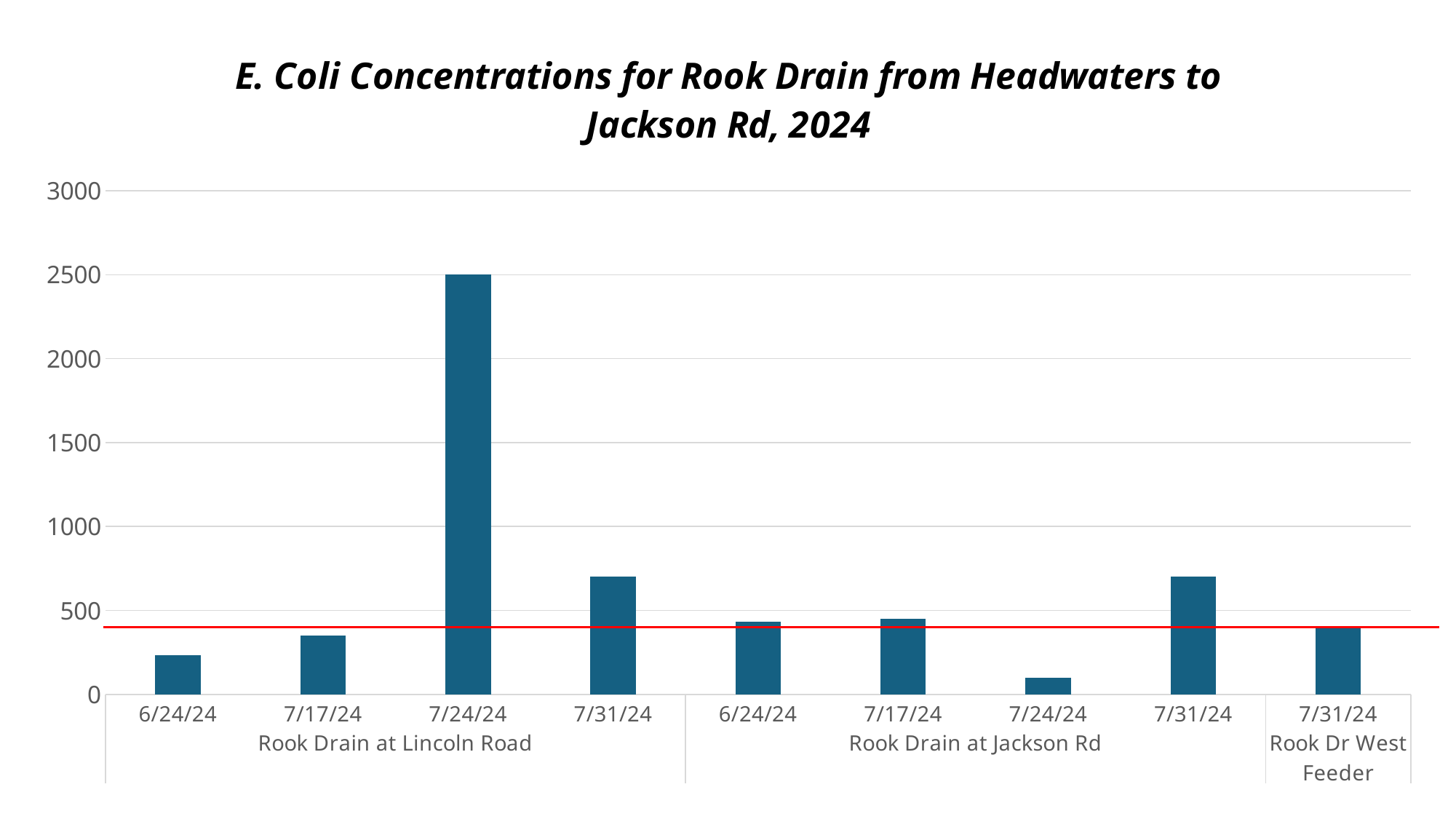
How many bars are plotted in the chart? 9 What is the title of the chart? E. Coli Concentrations for Rook Drain from Headwaters to Jackson Rd, 2024 What is the E. coli concentration for 7/24/24 at Rook Drain at Lincoln Road? 2500 What colour is the horizontal reference line drawn across the chart? Red Is the value for 6/24/24 at Rook Drain at Lincoln Road greater or less than 500? less How many sampling sites are labelled along the x axis? 3 Is the value for 7/31/24 at Rook Drain at Lincoln Road greater or less than 500? greater Which is larger: the 7/24/24 value at Rook Drain at Lincoln Road or the 7/24/24 value at Rook Drain at Jackson Rd? 7/24/24 at Rook Drain at Lincoln Road Is the value for 7/24/24 at Rook Drain at Jackson Rd greater or less than 500? less Which bar has the highest E. coli concentration? 7/24/24 at Rook Drain at Lincoln Road What kind of chart is shown on the slide? Bar chart Which bar has the lowest E. coli concentration? 7/24/24 at Rook Drain at Jackson Rd